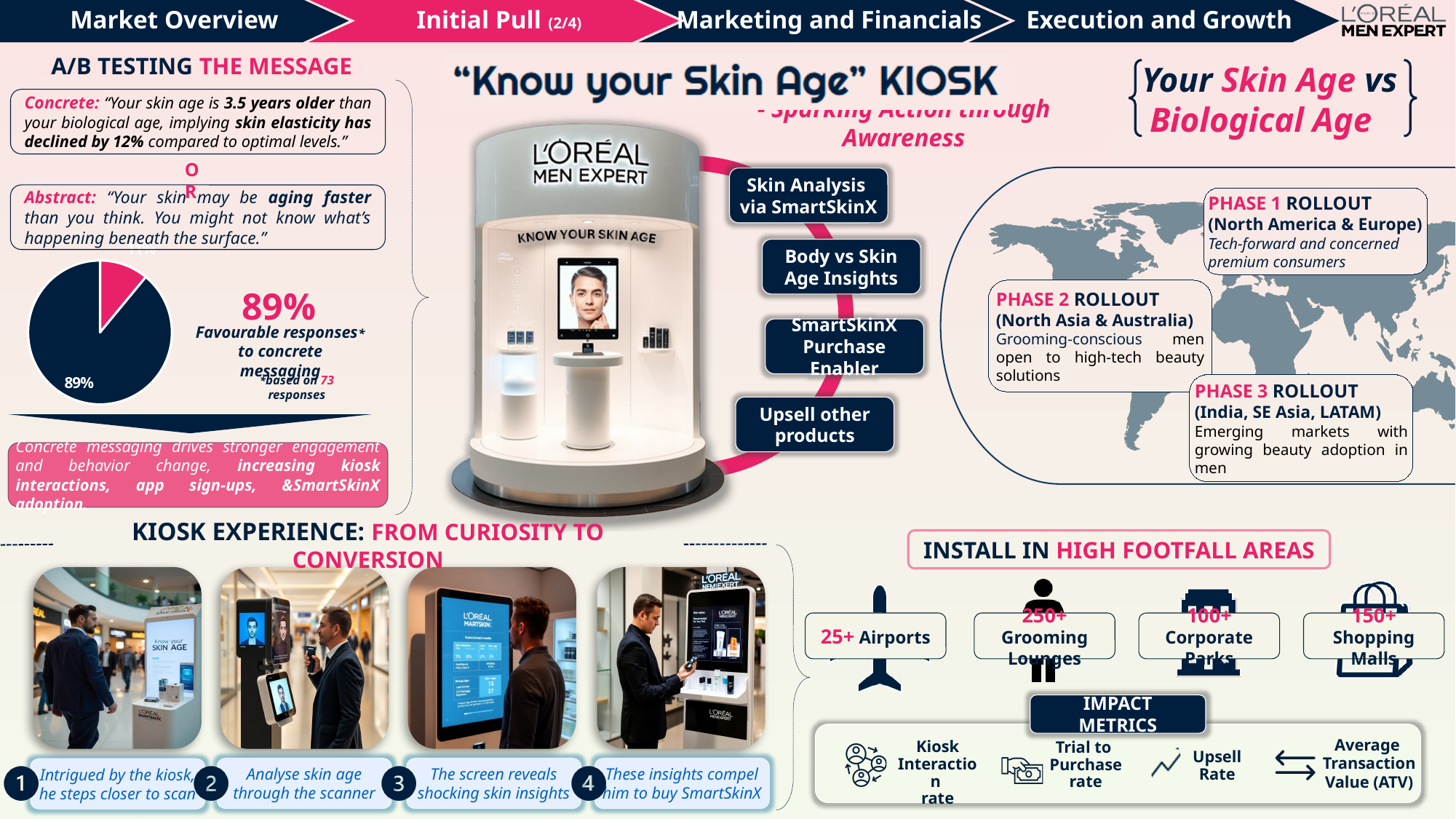
How many slices does the pie chart have? 2 What kind of chart is shown under the A/B Testing the Message section? Pie chart Which slice of the pie chart is larger, the favourable responses slice or the other slice? Favourable responses (89%) How many responses is the pie chart based on, according to the note next to it? 73 Is the smaller (pink) slice of the pie chart greater or less than 25%? less What colour is the 89% slice of the pie chart? Dark navy blue Is the favourable responses share in the pie chart greater or less than 50%? greater What share of the pie chart is taken by the largest slice? 89% In the pie chart, what percentage of responses were favourable to concrete messaging? 89%